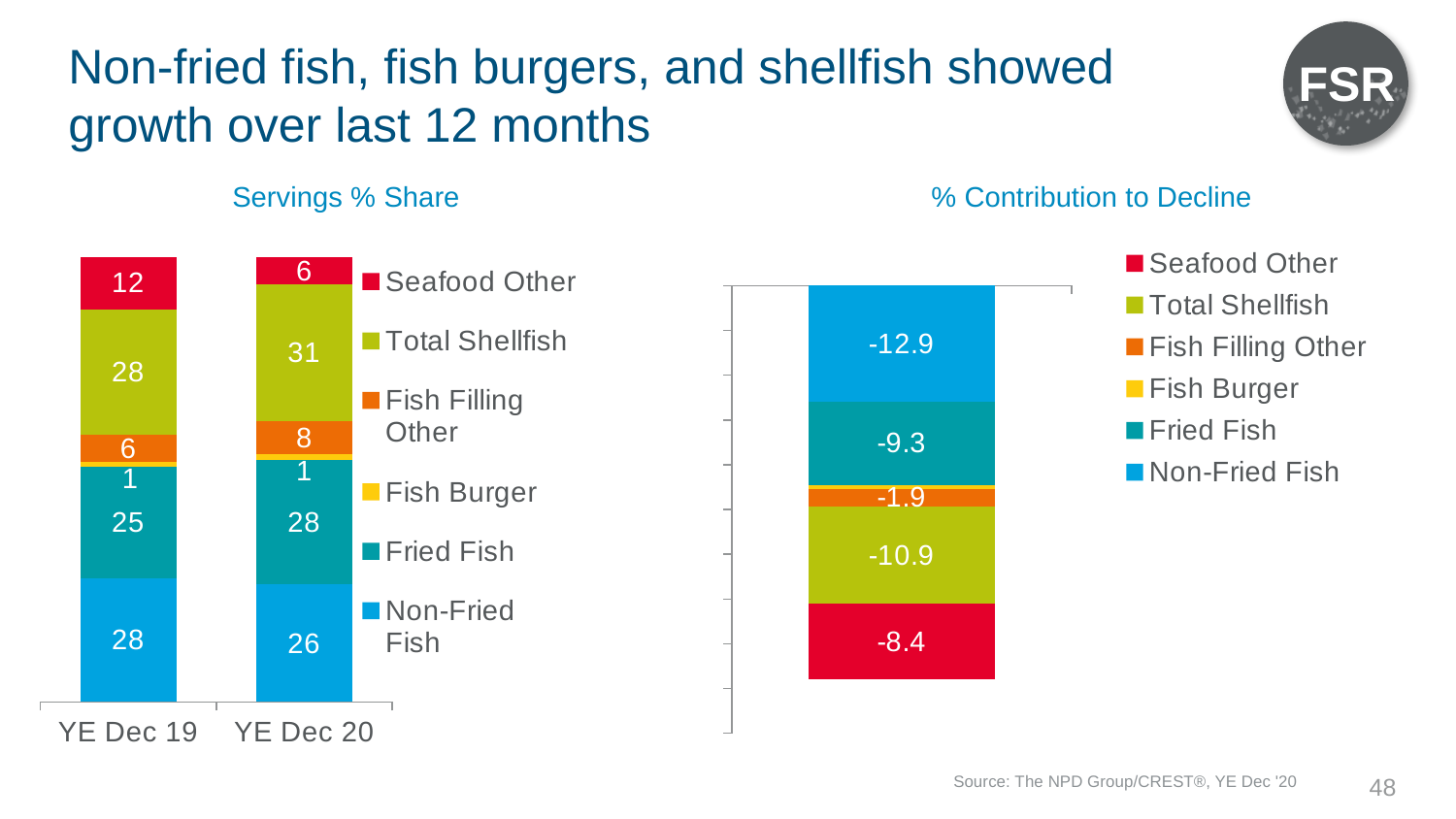
In the Servings % Share chart, which series has the smallest value in YE Dec 19? Fish Burger In the Servings % Share chart, what is the total of the YE Dec 20 stacked bar? 100 How many categories are shown on the x axis of the Servings % Share chart? 2 What kind of chart is the % Contribution to Decline chart? Stacked bar chart How many series does the legend of the % Contribution to Decline chart list? 6 In the Servings % Share chart, what is the value for Total Shellfish in YE Dec 20? 31 In the Servings % Share chart, which is larger for Fried Fish: YE Dec 19 or YE Dec 20? YE Dec 20 In the % Contribution to Decline chart, what is the value for Non-Fried Fish? -12.9 In the % Contribution to Decline chart, what is the value for Total Shellfish? -10.9 In the Servings % Share chart, what is the value for Seafood Other in YE Dec 19? 12 In the Servings % Share chart, what is the value for Non-Fried Fish in YE Dec 20? 26 In the Servings % Share chart, by how much did Seafood Other change from YE Dec 19 to YE Dec 20? 6